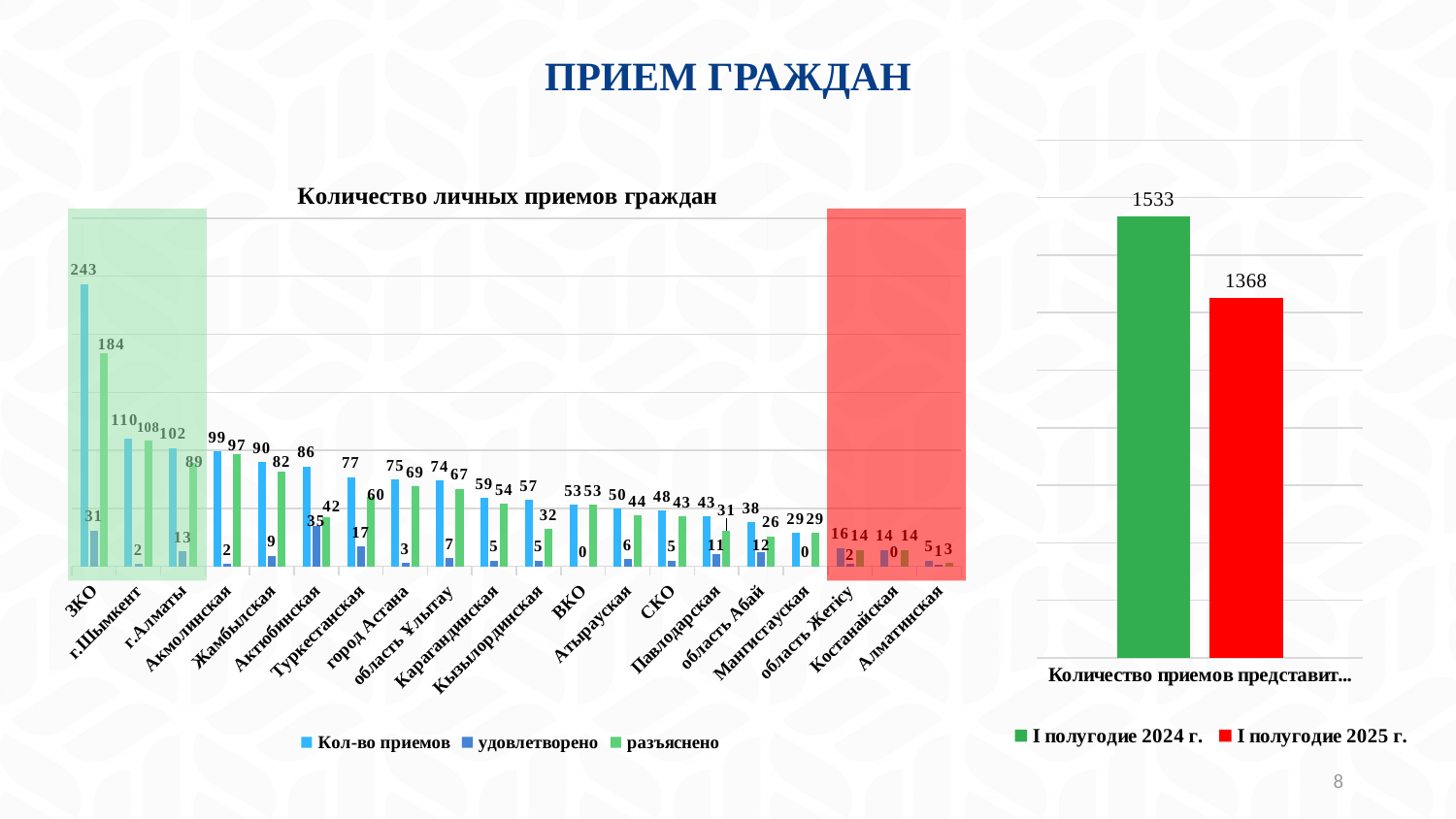
In the chart 'Количество личных приемов граждан', which category has the lowest 'Кол-во приемов'? Алматинская In the chart 'Количество личных приемов граждан', which is larger: 'удовлетворено' for Актюбинская or for ЗКО? Актюбинская In the chart 'Количество личных приемов граждан', what is the value of 'разъяснено' for Актюбинская? 42 In the chart 'Количество личных приемов граждан', what is the value of 'удовлетворено' for Павлодарская? 11 In the chart 'Количество личных приемов граждан', what is the difference between 'Кол-во приемов' for ЗКО and for г.Шымкент? 133 In the chart 'Количество личных приемов граждан', what is the value of 'Кол-во приемов' for ЗКО? 243 In the right-hand chart, what is the value for 'I полугодие 2024 г.'? 1533 How many categories are shown on the x axis of the chart 'Количество личных приемов граждан'? 20 What kind of chart is the right-hand chart on the slide? Bar chart In the right-hand chart, what is the difference between the values for 'I полугодие 2024 г.' and 'I полугодие 2025 г.'? 165 How many series does the legend of the chart 'Количество личных приемов граждан' list? 3 In the chart 'Количество личных приемов граждан', which category has the highest 'Кол-во приемов'? ЗКО